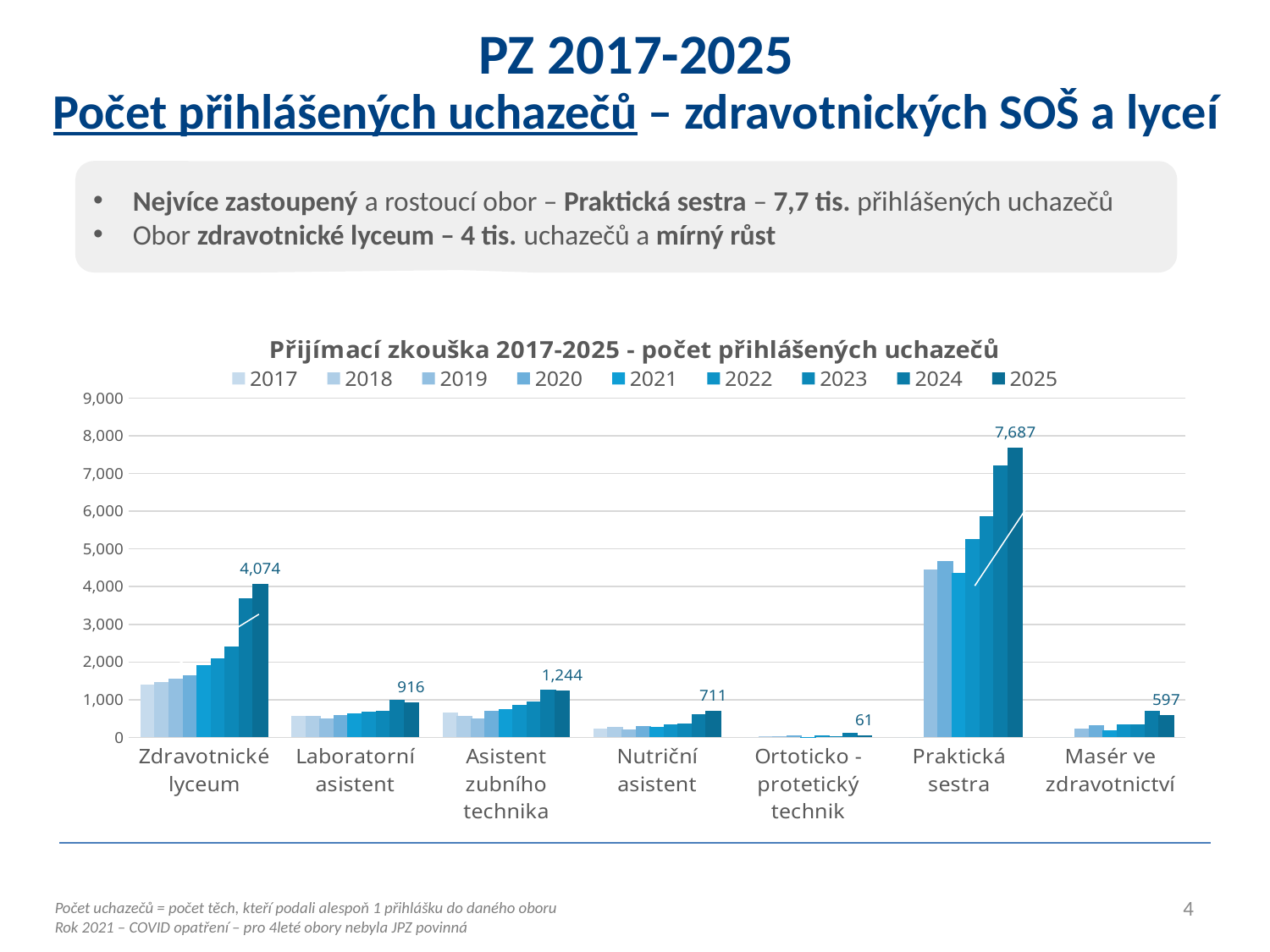
How many series does the legend list? 9 Which category has the highest 2025 value? Praktická sestra Do the values for Praktická sestra rise or fall from 2021 to 2025? rise Which category has the lowest 2025 value? Ortoticko - protetický technik What is the 2025 value for Ortoticko - protetický technik? 61 How many categories are shown on the x axis? 7 What is the 2025 value for Masér ve zdravotnictví? 597 What is the 2025 value for Zdravotnické lyceum? 4,074 What is the difference between the 2025 values for Praktická sestra and Zdravotnické lyceum? 3,613 Is the 2017 value for Zdravotnické lyceum greater or less than 2,000? less What is the 2025 value for Praktická sestra? 7,687 Which has the larger 2025 value, Laboratorní asistent or Nutriční asistent? Laboratorní asistent